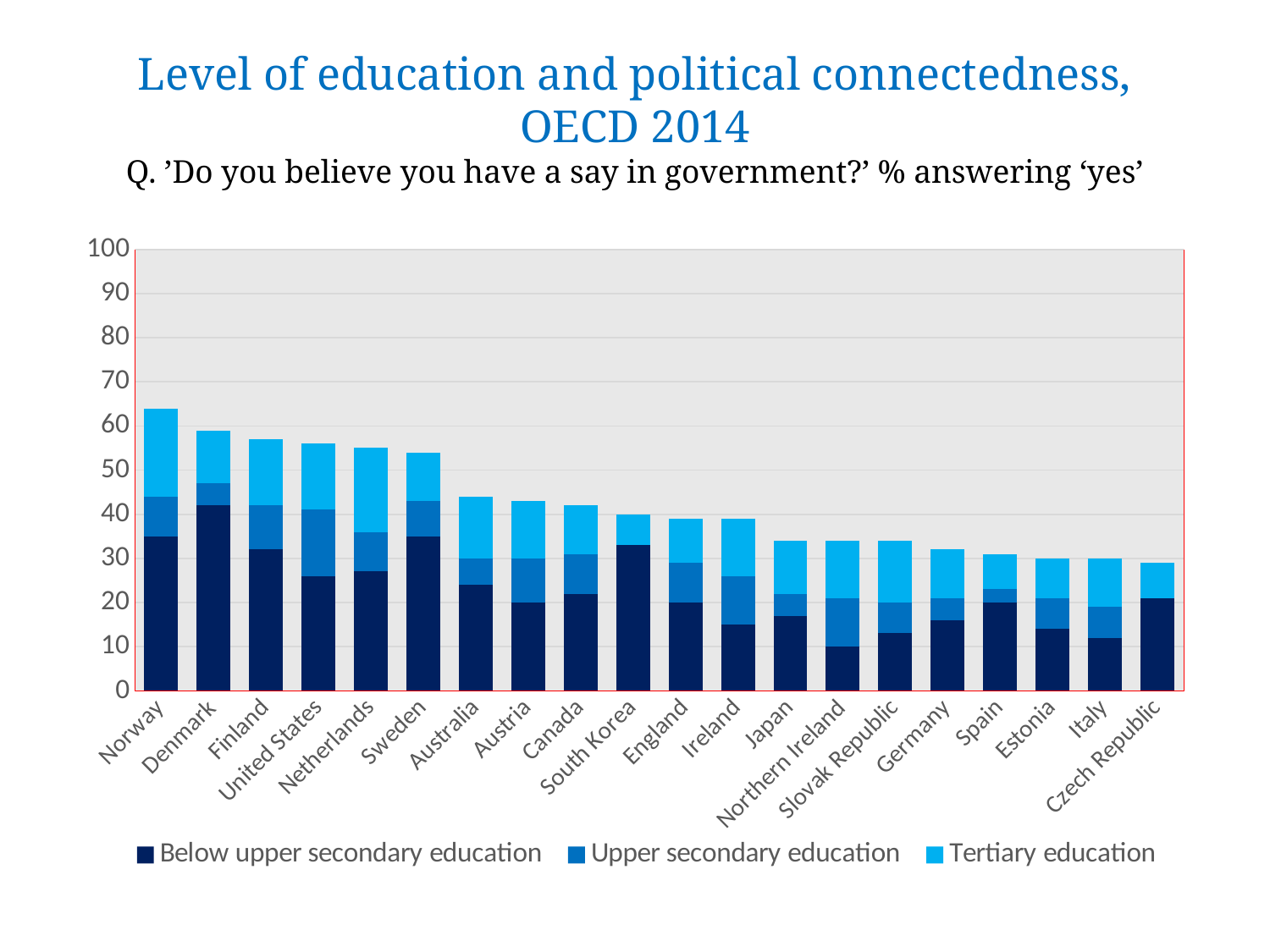
Which series is shown in the darkest blue colour? Below upper secondary education How many series does the legend list? 3 Which country has the highest total stacked bar? Norway Which country has the highest value for Below upper secondary education? Denmark What kind of chart is shown on the slide? stacked bar chart Is the total stacked value for Japan greater or less than 40? less How many countries are shown on the x axis of the chart? 20 Which has the larger total stacked bar, Norway or Denmark? Norway Is the total stacked value for Norway greater or less than 60? greater Is the total stacked value for South Korea greater or less than 30? greater Do the total stacked values generally rise or fall from left to right along the x axis? fall